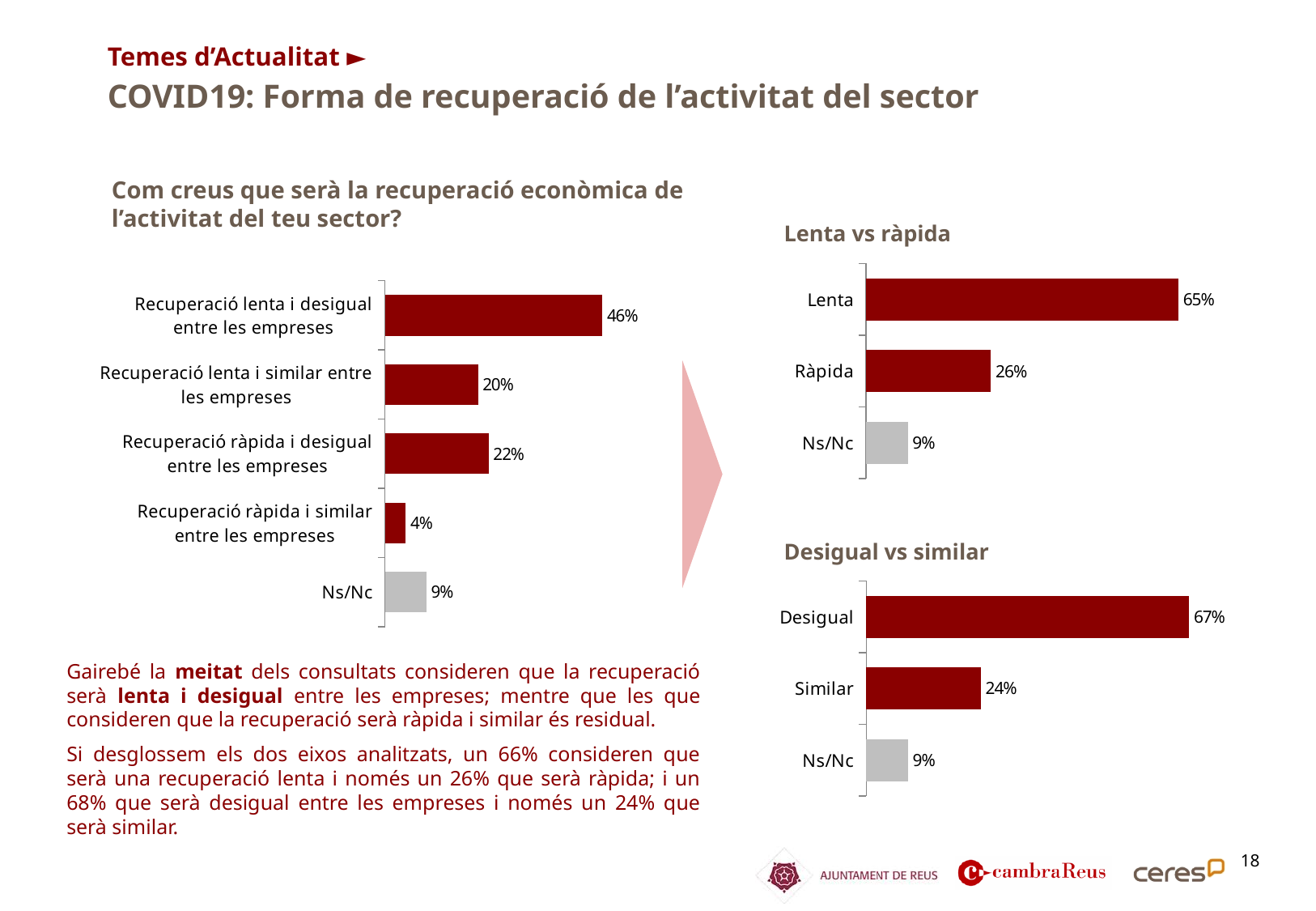
In the 'Lenta vs ràpida' chart, what is the difference between Lenta and Ràpida? 39% In the 'Lenta vs ràpida' chart, what is the value for Lenta? 65% In the left chart, how many categories are shown? 5 In the left chart 'Com creus que serà la recuperació econòmica de l'activitat del teu sector?', what percentage chose 'Recuperació lenta i desigual entre les empreses'? 46% In the 'Desigual vs similar' chart, what is the value for Similar? 24% In the left chart, what is the value for Ns/Nc? 9% In the left chart, which category has the lowest value? Recuperació ràpida i similar entre les empreses In the 'Desigual vs similar' chart, what colour is the Ns/Nc bar? grey In the 'Desigual vs similar' chart, which category has the highest value? Desigual In the 'Desigual vs similar' chart, is the value for Desigual larger or smaller than the value for Similar? larger What type of chart is the 'Lenta vs ràpida' chart? bar chart In the left chart, what is the difference between 'Recuperació ràpida i desigual entre les empreses' and 'Recuperació lenta i similar entre les empreses'? 2%